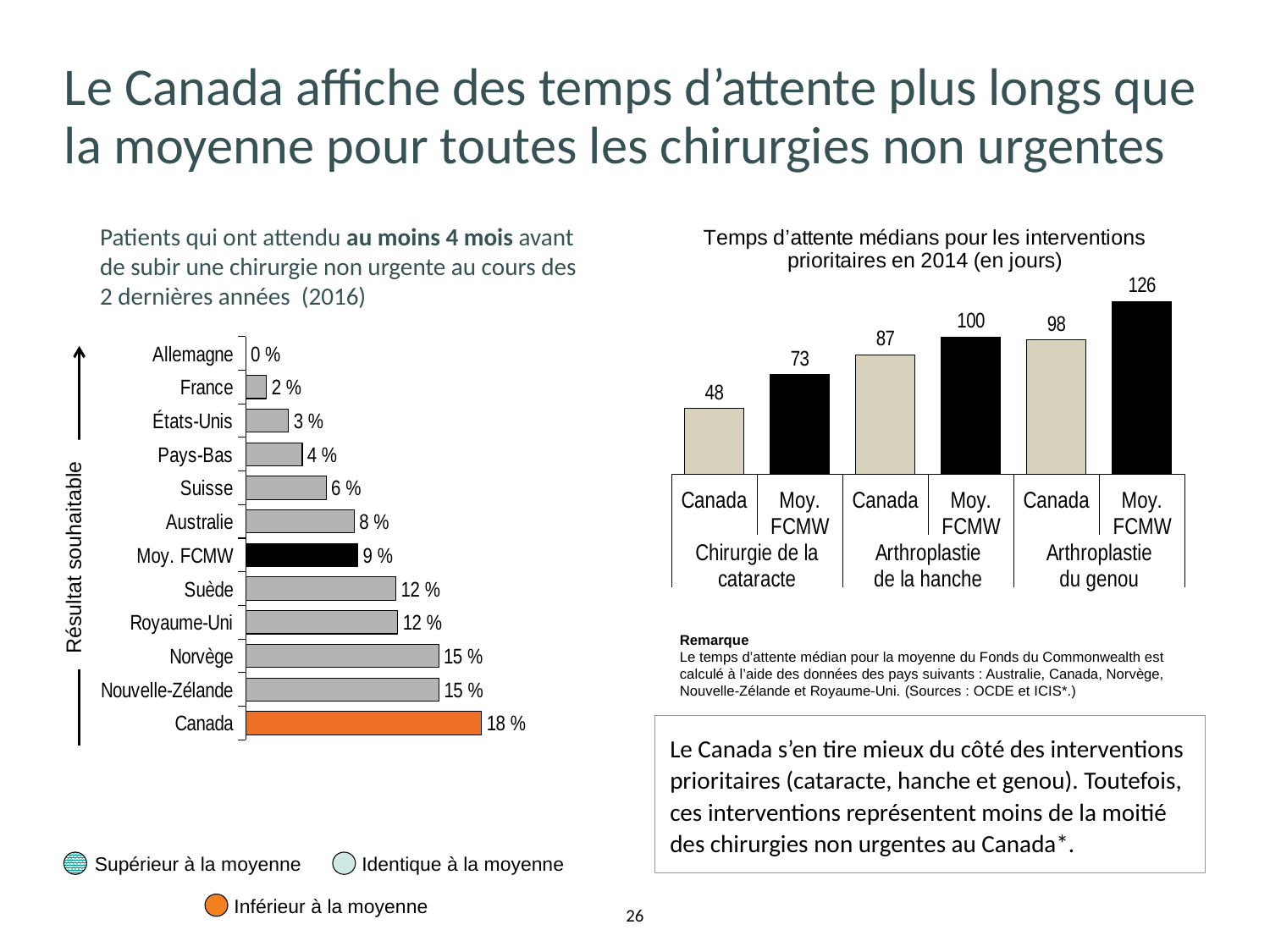
In the right chart (Temps d'attente médians pour les interventions prioritaires en 2014), what is the value for Canada for Chirurgie de la cataracte? 48 In the right chart (Temps d'attente médians pour les interventions prioritaires en 2014), which bar has the highest value? Moy. FCMW, Arthroplastie du genou In the right chart (Temps d'attente médians pour les interventions prioritaires en 2014), what is the difference between Moy. FCMW and Canada for Arthroplastie de la hanche? 13 In the left chart (patients who waited at least 4 months), which country has the highest value? Canada In the right chart (Temps d'attente médians pour les interventions prioritaires en 2014), what is the value for Moy. FCMW for Arthroplastie du genou? 126 In the left chart (patients who waited at least 4 months), what is the value for Canada? 18 % In the left chart (patients who waited at least 4 months), which is larger, the value for Suisse or the value for Australie? Australie What kind of chart is the left chart (patients who waited at least 4 months)? Bar chart In the left chart (patients who waited at least 4 months), how many categories are shown? 12 In the left chart (patients who waited at least 4 months), which country has the lowest value? Allemagne In the left chart (patients who waited at least 4 months), what is the difference between Canada and Moy. FCMW? 9 % In the left chart (patients who waited at least 4 months), what is the value for Moy. FCMW? 9 %